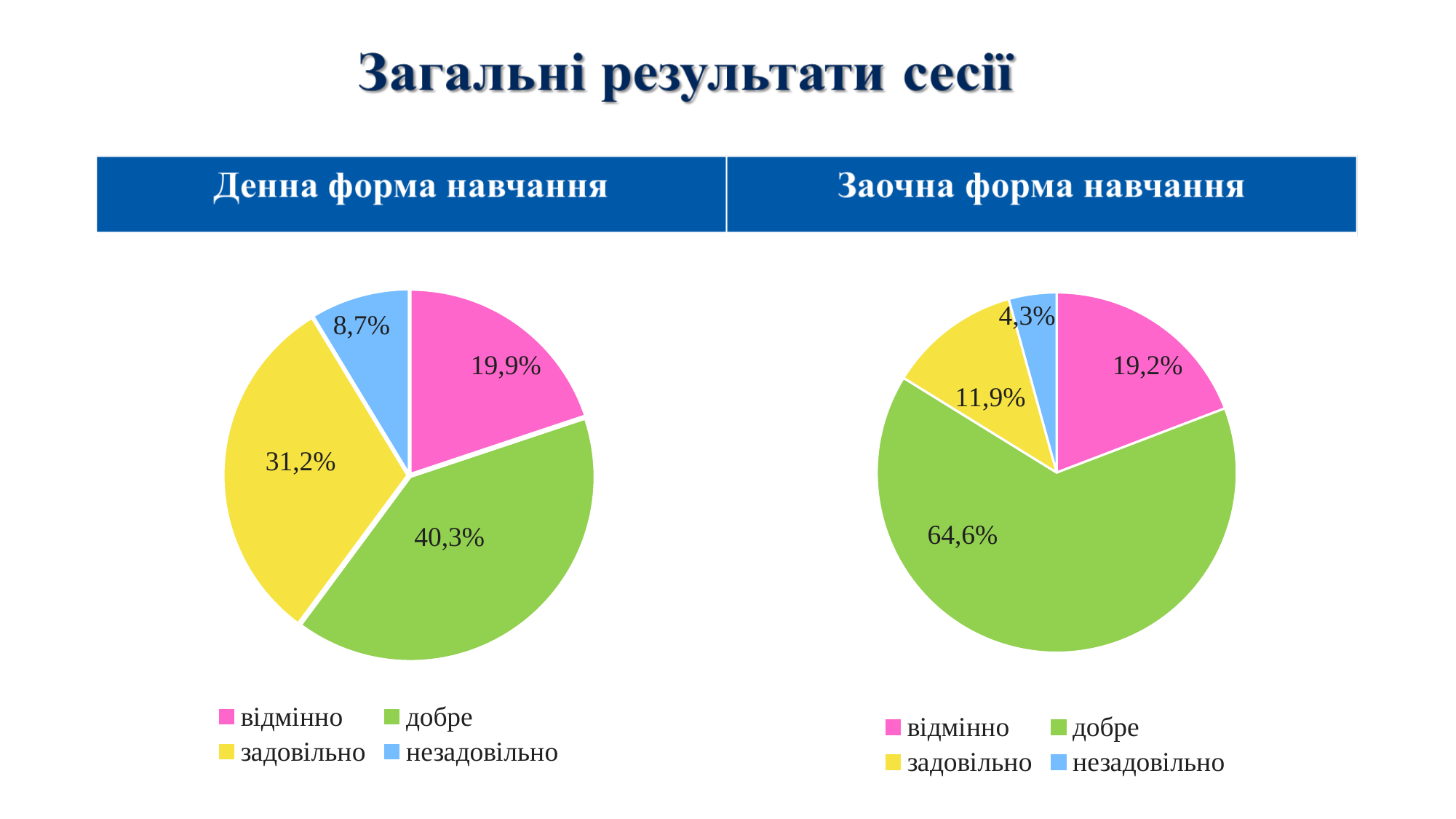
In the "Заочна форма навчання" chart, what share is labelled for "відмінно"? 19,2% In the "Заочна форма навчання" chart, what colour is the "добре" slice? Green In the "Денна форма навчання" chart, which category has the smallest slice? незадовільно In the "Денна форма навчання" chart, what share is labelled for "задовільно"? 31,2% In the "Заочна форма навчання" chart, what share is labelled for "незадовільно"? 4,3% In the "Денна форма навчання" chart, which is larger: the "задовільно" slice or the "відмінно" slice? задовільно What type of chart is used under "Денна форма навчання"? Pie chart In the "Денна форма навчання" chart, which category has the largest slice? добре In the "Заочна форма навчання" chart, which category has the smallest slice? незадовільно What is the difference between the "добре" share in the "Заочна форма навчання" chart and the "добре" share in the "Денна форма навчання" chart? 24,3% How many slices does the "Заочна форма навчання" pie chart have? 4 In the "Денна форма навчання" chart, what share is labelled for "добре"? 40,3%